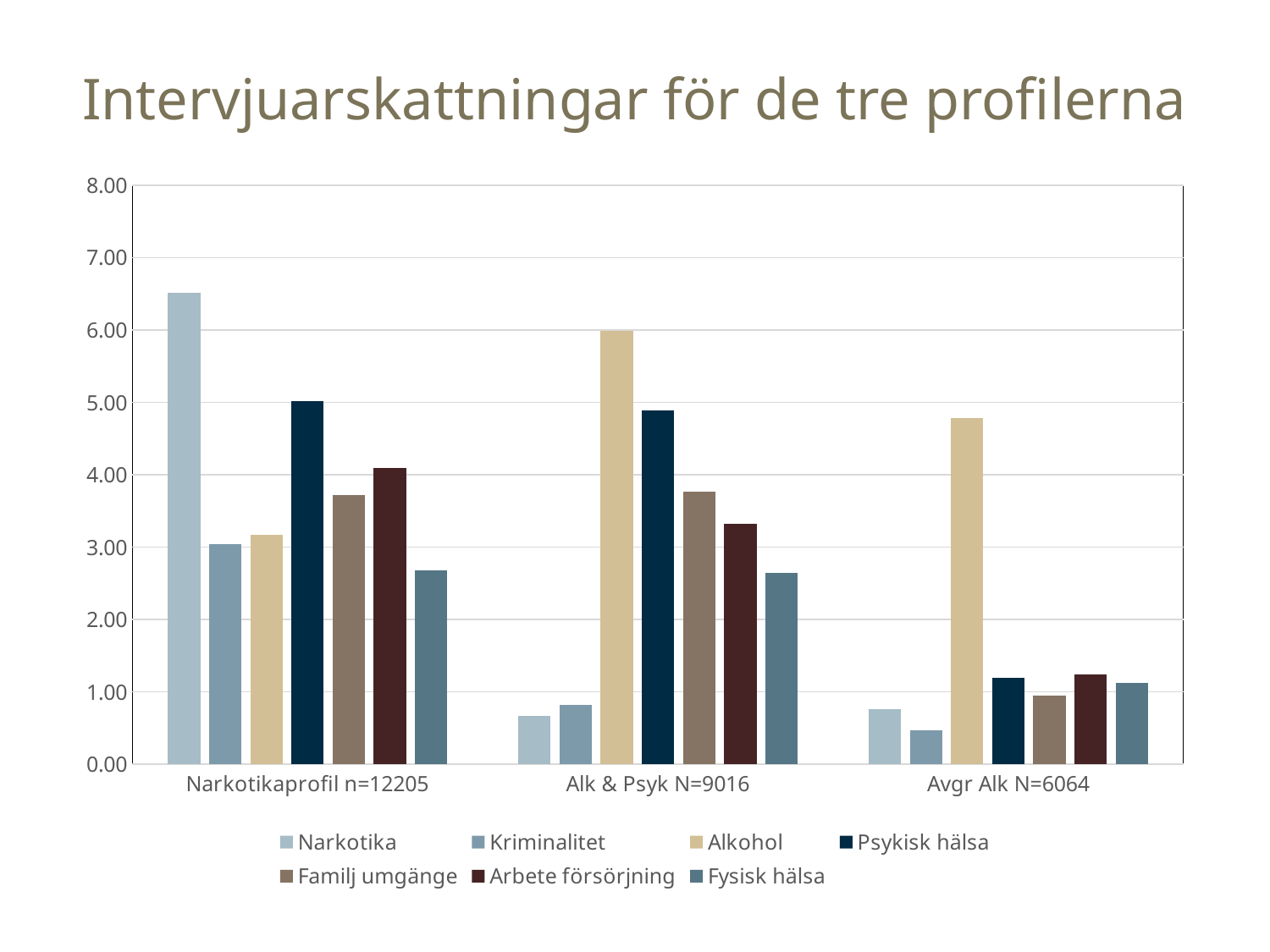
Which series has the highest value for Alk & Psyk N=9016? Alkohol What kind of chart is shown on the slide? Bar chart Is the value for Alkohol in Avgr Alk N=6064 greater or less than 5.00? less Which series has the lowest value for Avgr Alk N=6064? Kriminalitet Is the value for Fysisk hälsa in Alk & Psyk N=9016 greater or less than 3.00? less What is the title of the slide? Intervjuarskattningar för de tre profilerna Is the value for Narkotika in Narkotikaprofil n=12205 greater or less than 6.00? greater How many profile categories are shown on the x axis? 3 Which category has the larger Alkohol value: Alk & Psyk N=9016 or Avgr Alk N=6064? Alk & Psyk N=9016 How many series does the legend list? 7 Which series has the highest value for Narkotikaprofil n=12205? Narkotika In Narkotikaprofil n=12205, which is larger: Familj umgänge or Arbete försörjning? Arbete försörjning